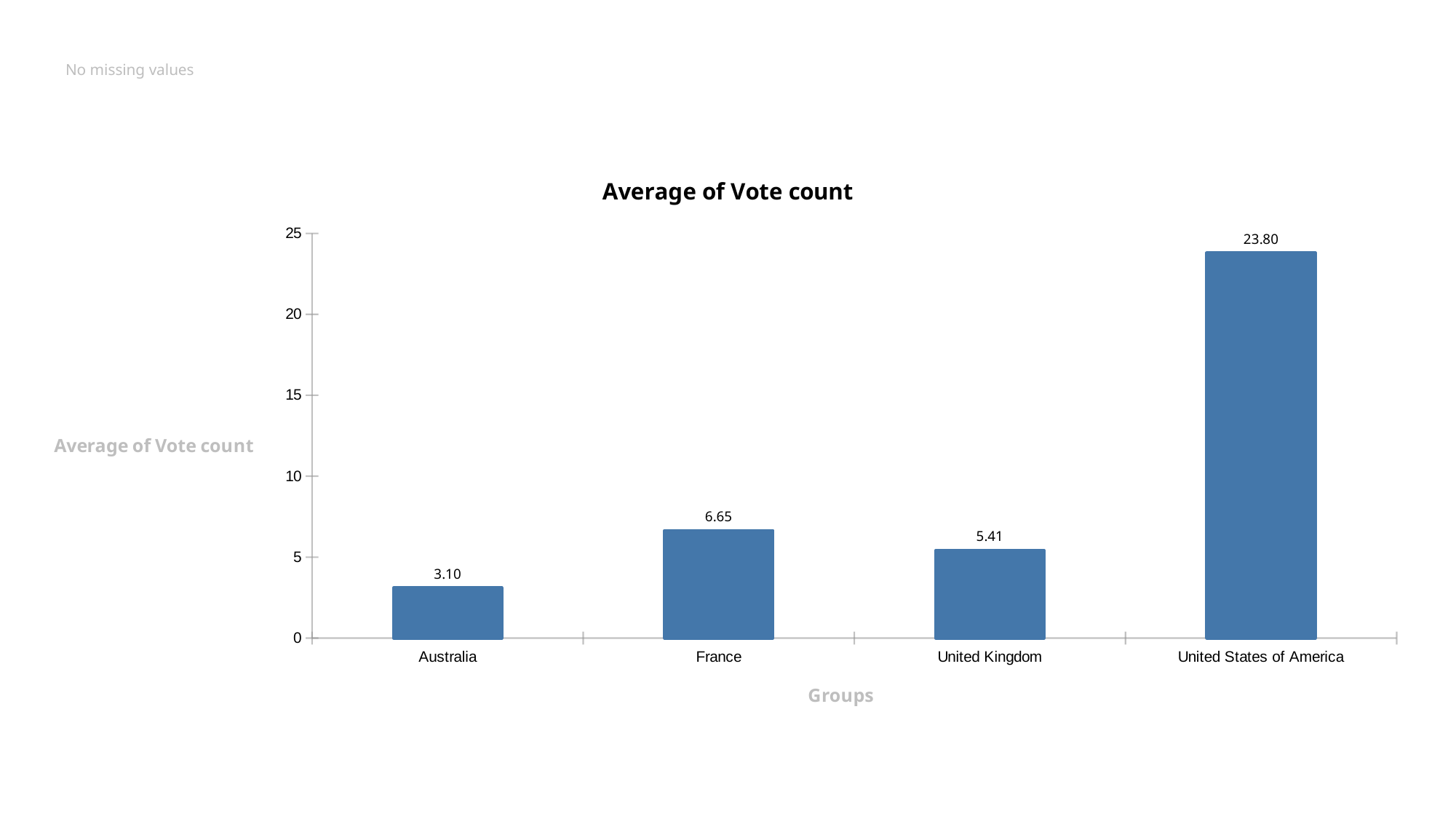
What is the average vote count for Australia? 3.10 Which has a higher average vote count, France or the United Kingdom? France Is the value for the United States of America greater or less than 20? greater How many groups are shown on the x axis? 4 Which group has the highest average vote count? United States of America What kind of chart is shown on the slide? Bar chart What is the title of the chart? Average of Vote count What is the average vote count for the United Kingdom? 5.41 What is the average vote count for France? 6.65 Which group has the lowest average vote count? Australia What is the difference between the average vote count for the United States of America and France? 17.15 What is the average vote count for the United States of America? 23.80